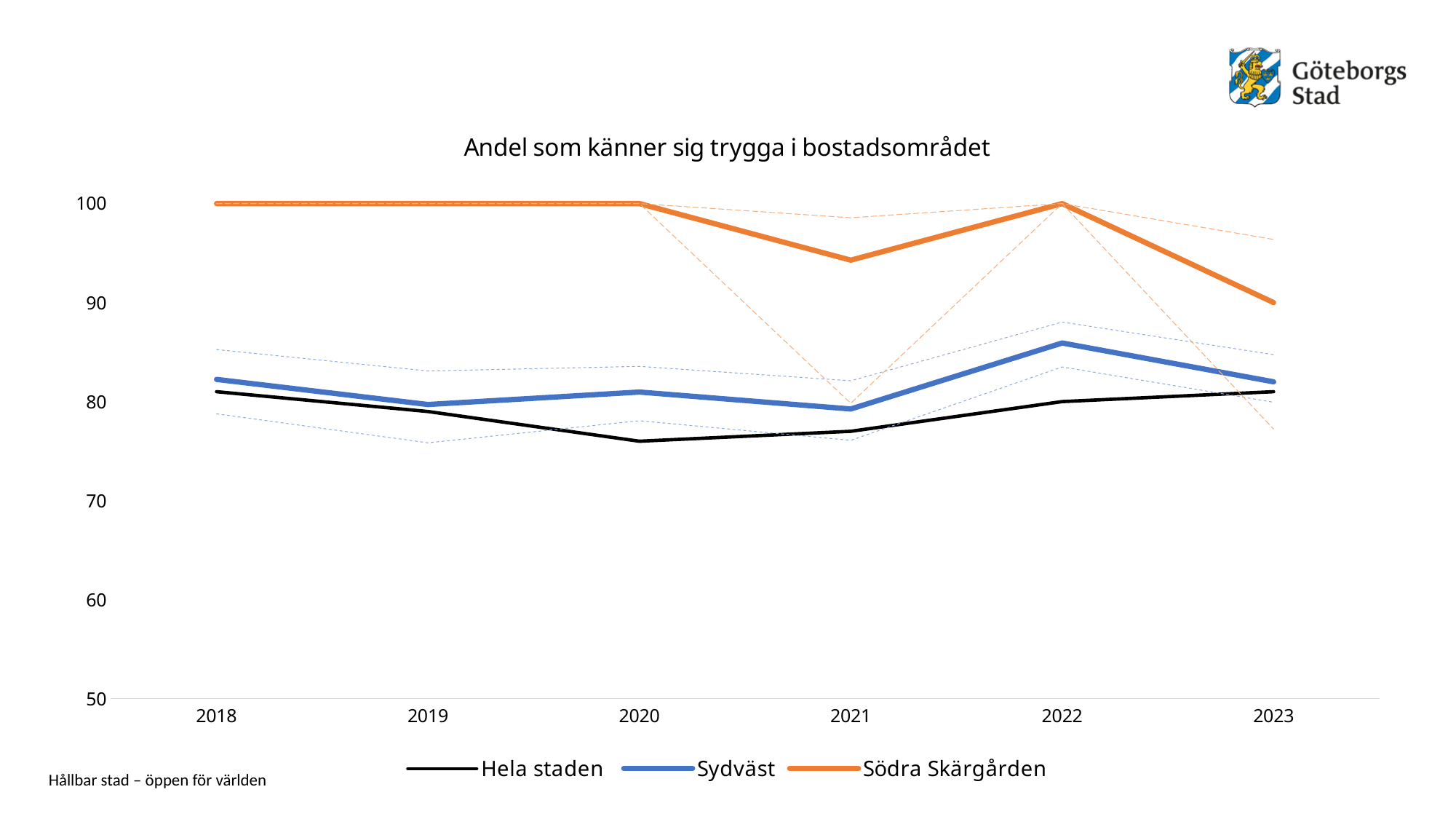
Is the value for Hela staden in 2020 greater or less than 80? less How many series does the legend list? 3 Which series has the highest value in 2021? Södra Skärgården Is the value for Södra Skärgården in 2021 greater or less than 90? greater Is the value for Sydväst larger in 2021 or in 2022? 2022 What is the value for Södra Skärgården in 2018? 100 What kind of chart is shown on the slide? line chart Does the Södra Skärgården line rise or fall from 2022 to 2023? fall Is the value for Sydväst in 2022 greater or less than 80? greater What is the value for Södra Skärgården in 2020? 100 Which series has the lowest value in 2020? Hela staden How many years are shown on the x axis? 6